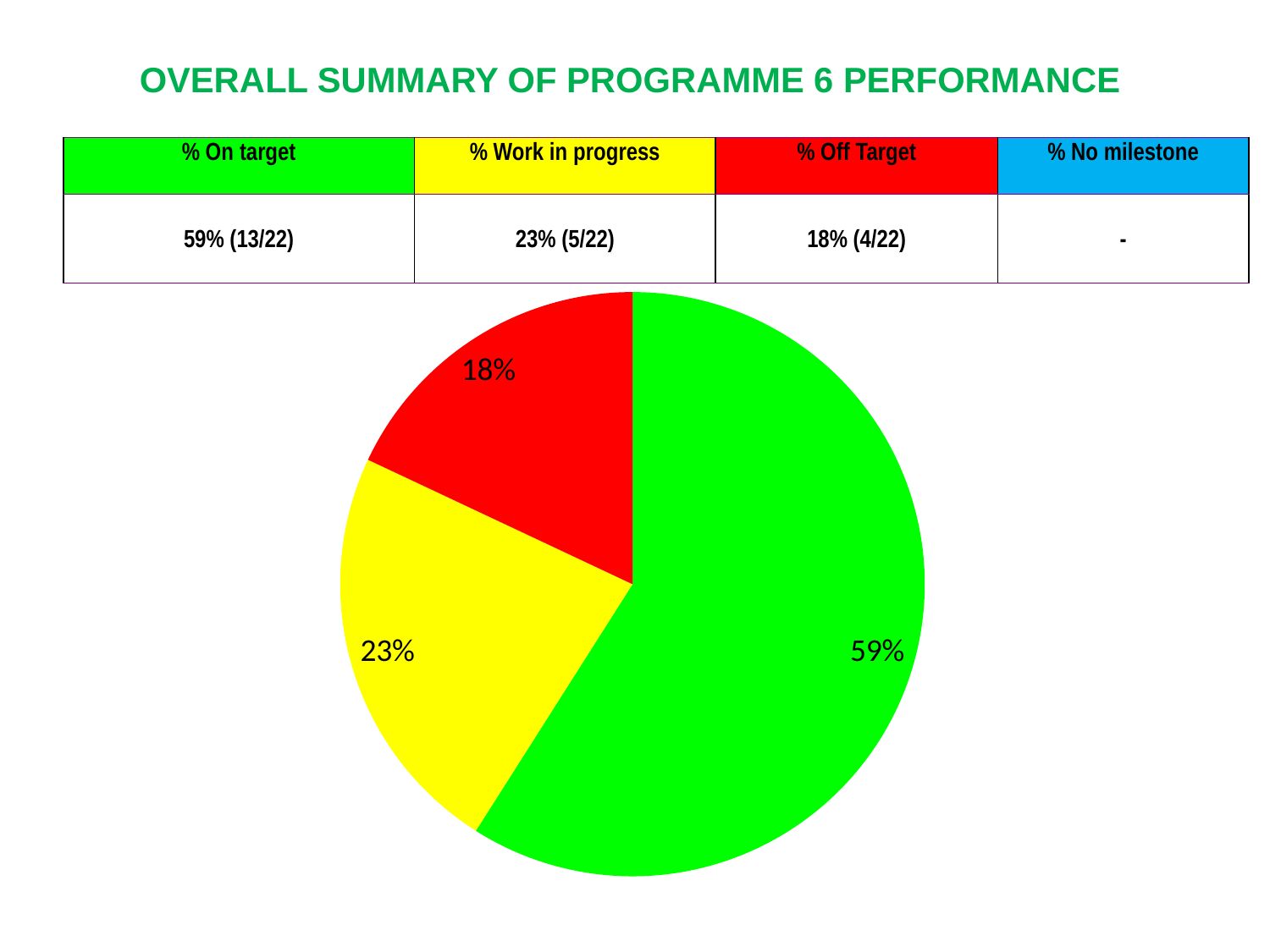
Which slice of the pie chart is the smallest? the red slice (18%) What kind of chart is shown on the slide? pie chart What percentage is shown on the yellow slice of the pie chart? 23% How many slices does the pie chart have? 3 What percentage is shown on the red slice of the pie chart? 18% Which slice of the pie chart is the largest? the green slice (59%) According to the table above the pie chart, which category does the green slice represent? % On target What is the difference between the green slice and the yellow slice in the pie chart? 36% What is the title shown above the chart on the slide? OVERALL SUMMARY OF PROGRAMME 6 PERFORMANCE What is the difference between the yellow slice and the red slice in the pie chart? 5% Which is larger in the pie chart, the yellow slice or the red slice? the yellow slice What percentage is shown on the green slice of the pie chart? 59%